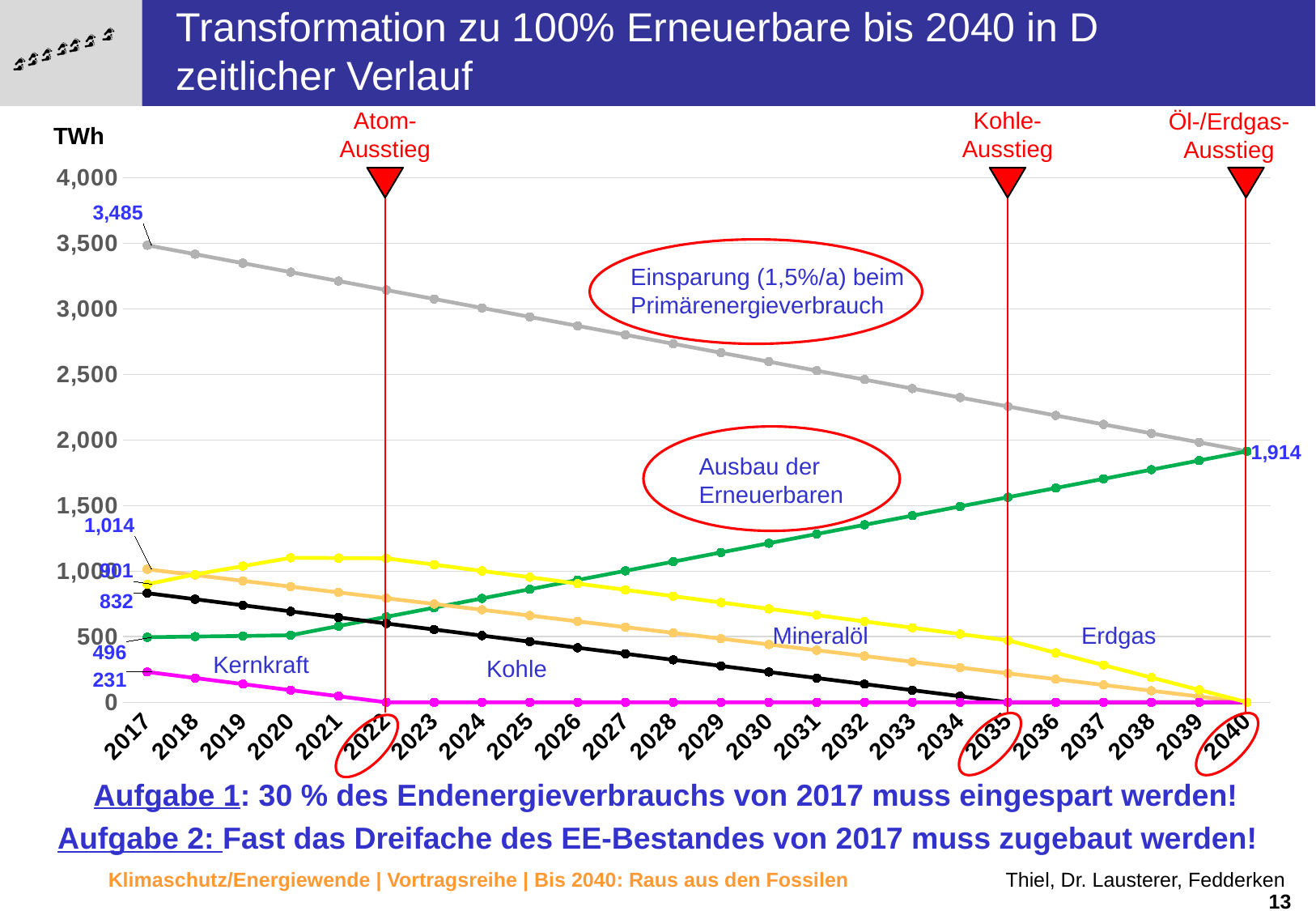
What kind of chart is shown on the slide? line chart How many years are shown on the x axis? 24 What value does the green Erneuerbare line reach in 2040? 1,914 In 2017, which is larger: Mineralöl (1,014) or Erdgas (901)? Mineralöl By how much does the green Erneuerbare line grow from 2017 (496) to 2040 (1,914)? 1,418 What is the value of the Kohle line in 2017? 832 Is the value of the green Erneuerbare line in 2030 greater or less than 1,000? greater What is the value of the Kernkraft line in 2017? 231 By how much does the grey primary energy line fall from 2017 (3,485) to 2040 (1,914)? 1,571 What is the value of the grey primary energy consumption line in 2017? 3,485 Does the grey primary energy consumption line rise or fall from 2017 to 2040? fall Is the value of the Kohle line in 2030 greater or less than 500? less